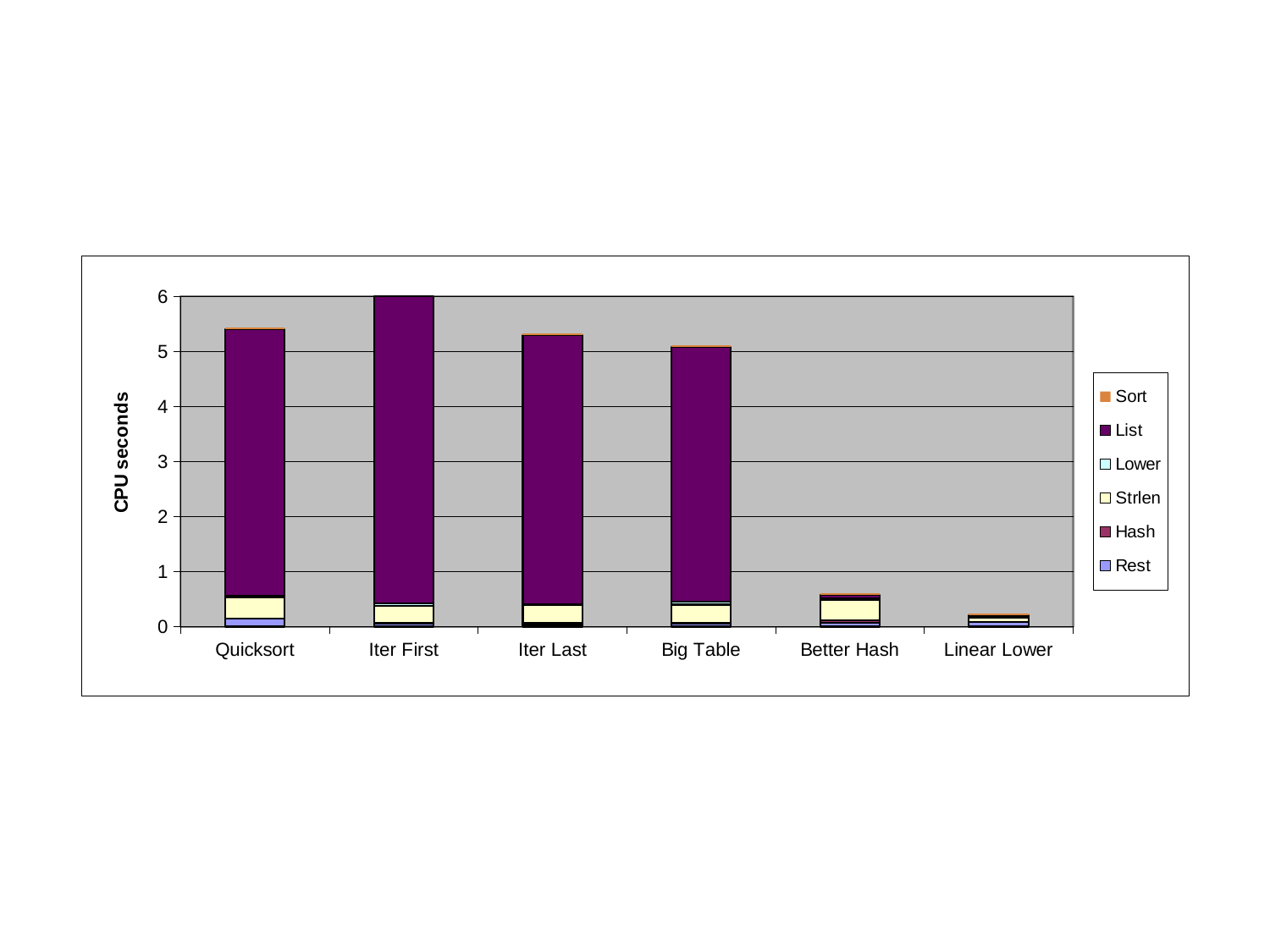
Is the total value for Quicksort greater or less than 5? greater Which has the larger total, Quicksort or Better Hash? Quicksort Which category has the tallest stacked bar? Iter First How many series does the legend list? 6 What is the label on the vertical axis? CPU seconds What kind of chart is shown on the slide? stacked bar chart Which category has the shortest stacked bar? Linear Lower Which has the larger total, Iter First or Iter Last? Iter First Is the total value for Better Hash greater or less than 1? less Is the total value for Iter Last greater or less than 5? greater How many categories are shown along the x axis? 6